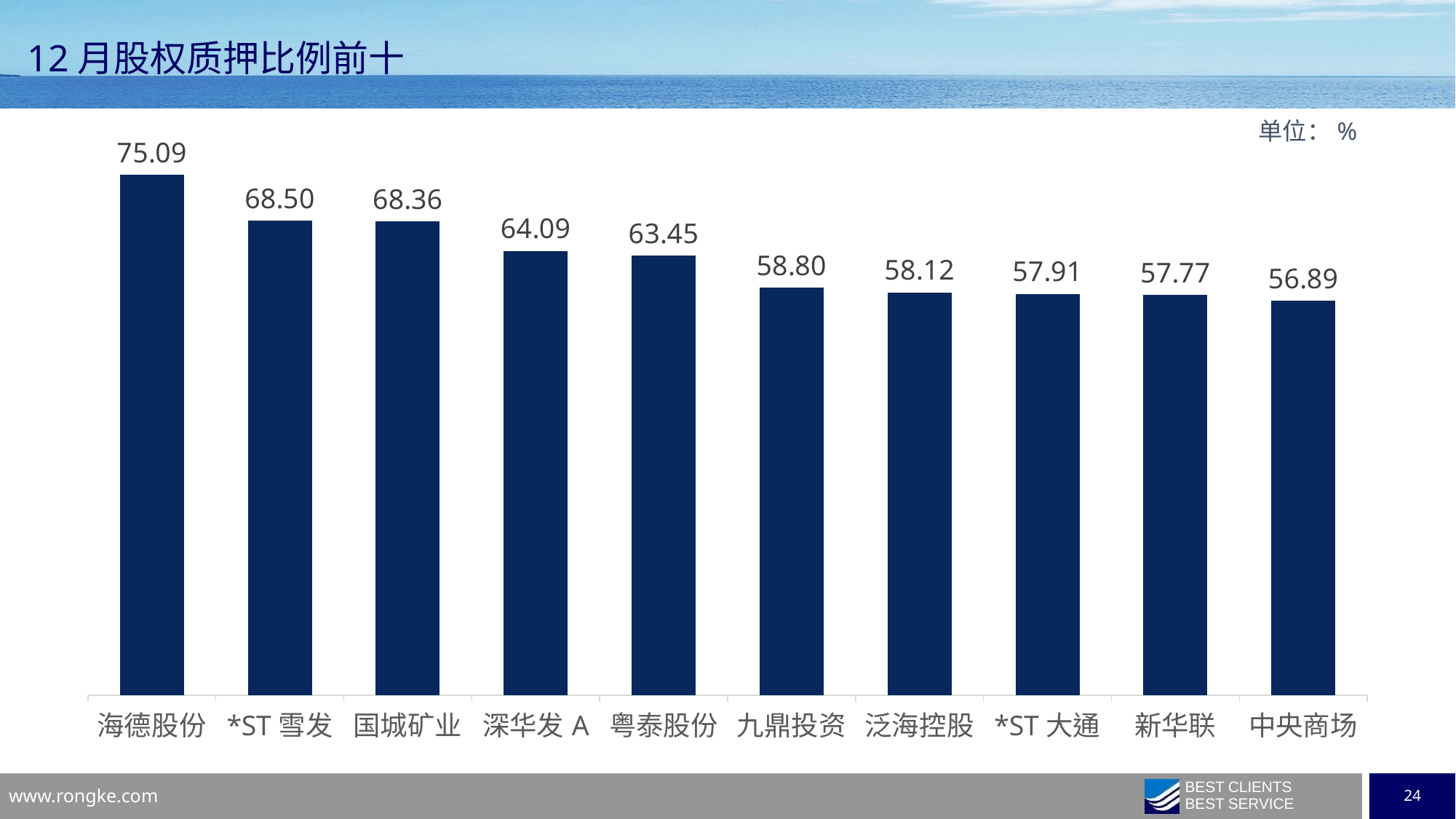
Which company has the lowest value? 中央商场 What is the value for 海德股份? 75.09 Which is larger, the value for 深华发 A or the value for 九鼎投资? 深华发 A Do the values rise or fall from left to right across the chart? fall How many companies are shown in the chart? 10 What unit is indicated for the values in the chart? % What is the value for 粤泰股份? 63.45 Which company has the highest value? 海德股份 What is the difference between the values for 海德股份 and 中央商场? 18.20 What kind of chart is shown on the slide? bar chart What is the difference between the values for *ST 雪发 and 国城矿业? 0.14 What is the value for 新华联? 57.77